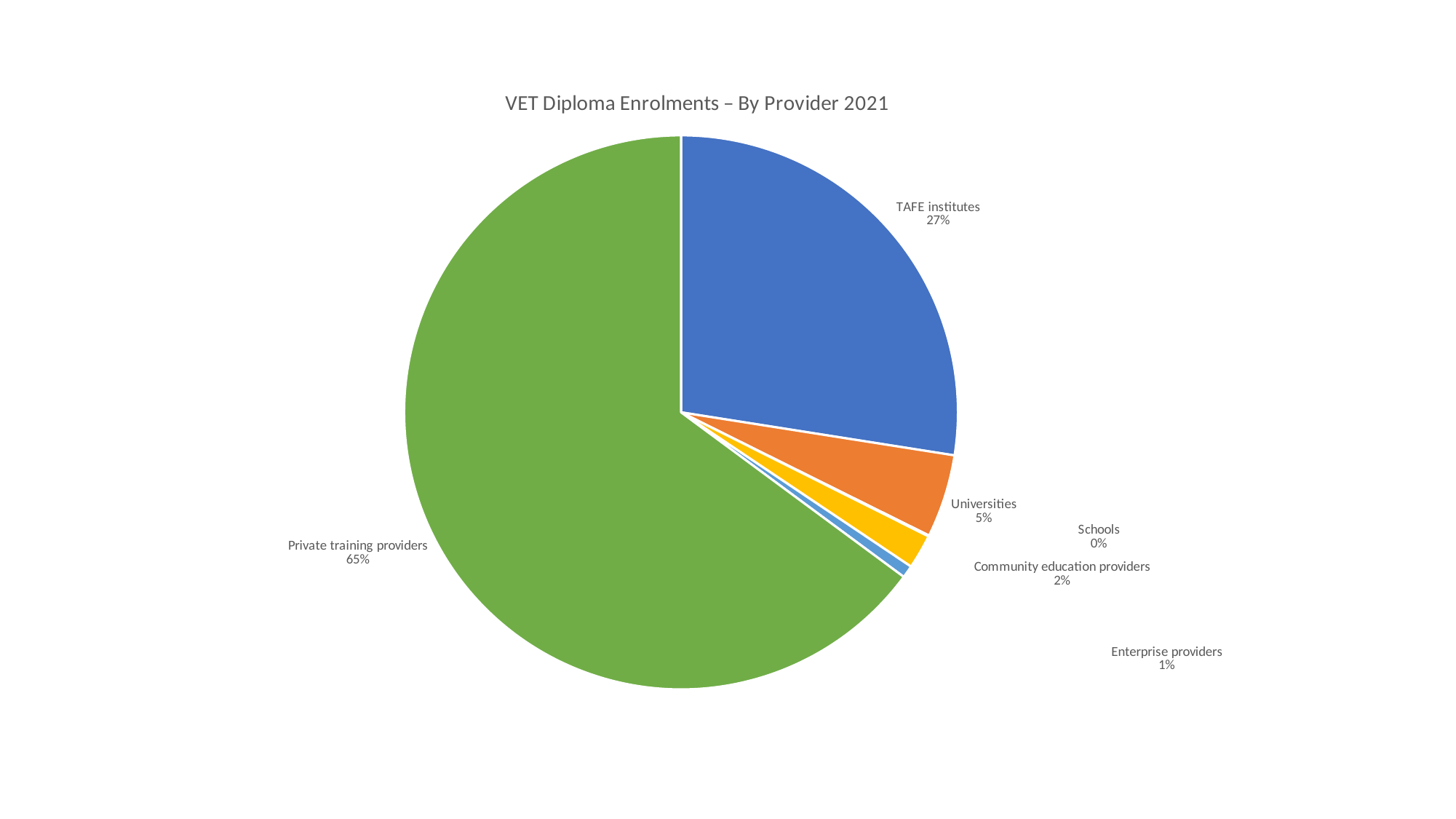
What percentage is shown for Universities? 5% Which provider type has the largest share of enrolments? Private training providers What percentage is shown for Enterprise providers? 1% What percentage is shown for Community education providers? 2% What share of VET Diploma enrolments is attributed to TAFE institutes? 27% What kind of chart is shown on the slide? pie chart What share of VET Diploma enrolments is attributed to Private training providers? 65% How many provider categories are shown in the pie chart? 6 What percentage is shown for Schools? 0% What is the title of the chart? VET Diploma Enrolments – By Provider 2021 What is the difference in percentage points between Private training providers and TAFE institutes? 38 Which provider type has the smallest share of enrolments? Schools